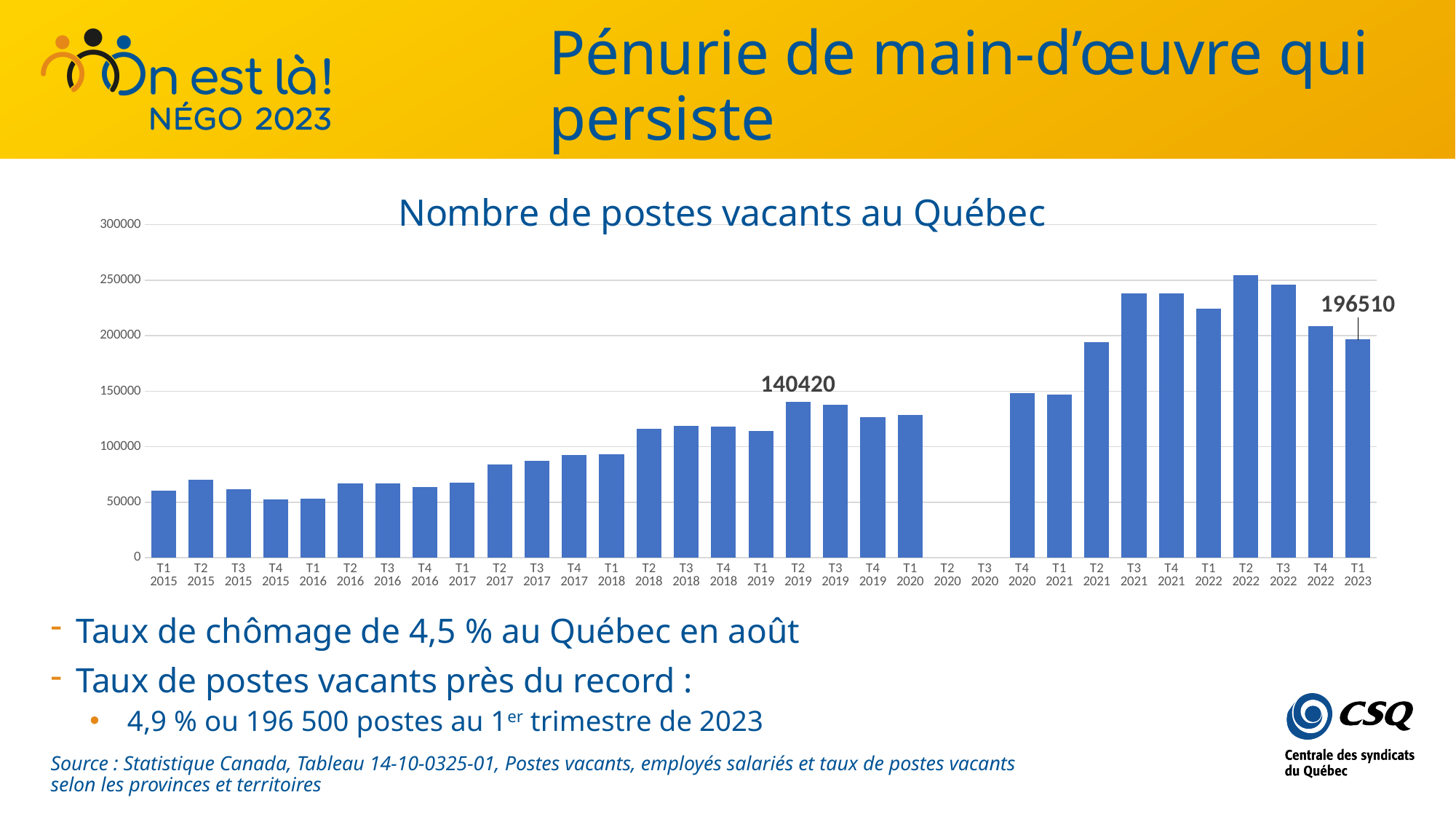
Is the value for T3 2021 greater or less than 200000? greater Is the value for T2 2022 greater or less than 250000? greater What is the value for T2 2019? 140420 What is the value for T1 2023? 196510 Which is larger, the value for T2 2022 or the value for T3 2022? T2 2022 Which quarters on the x axis have no bar plotted? T2 2020 and T3 2020 What is the title of the chart? Nombre de postes vacants au Québec What is the difference between the values for T1 2023 and T2 2019? 56090 Is the value for T1 2015 greater or less than 50000? greater Which quarter has the highest number of vacant positions? T2 2022 What type of chart is shown on the slide? bar chart Do the values generally rise or fall from T1 2015 to T2 2019? rise